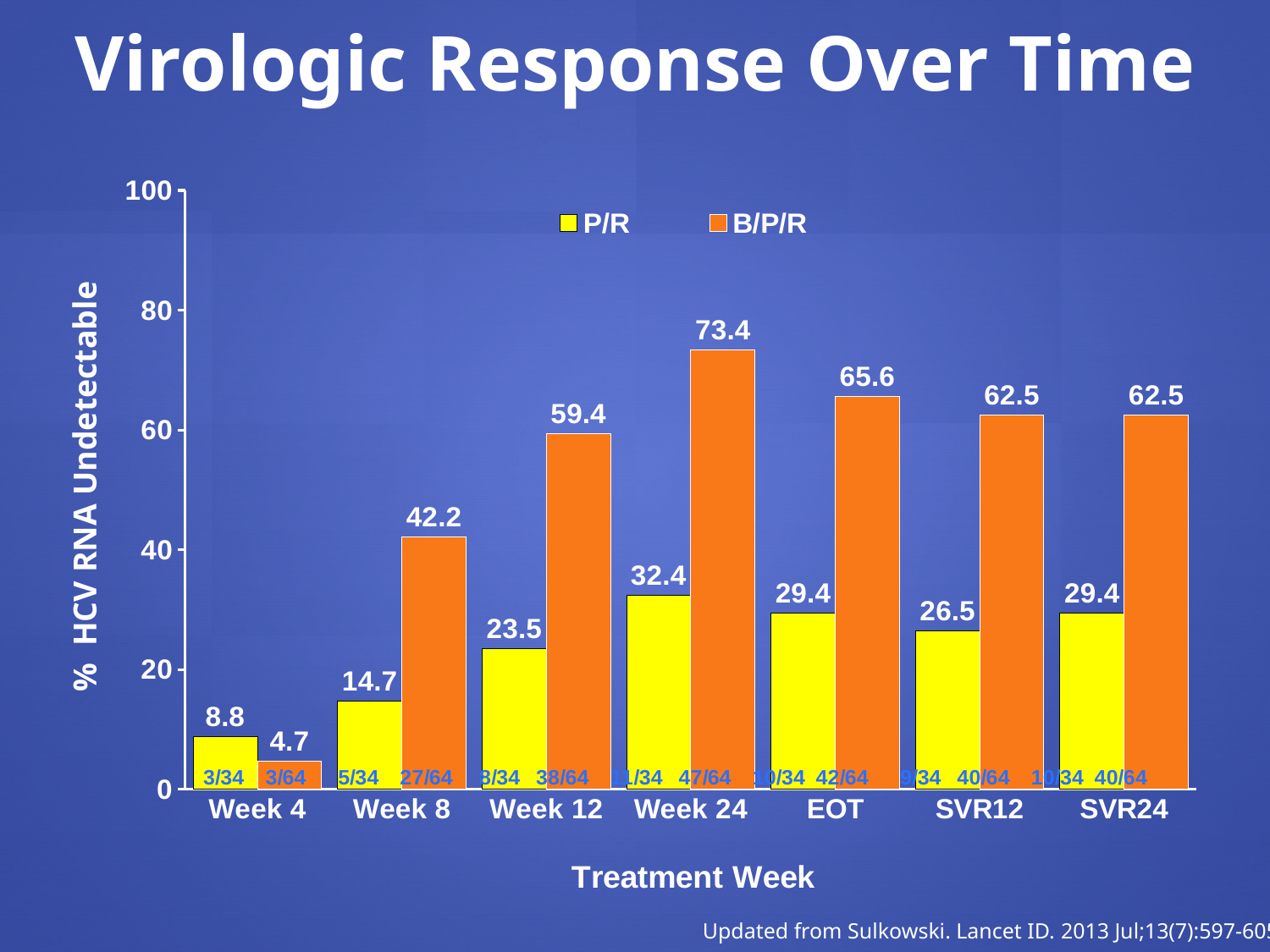
What type of chart is shown on the slide? bar chart What is the value for P/R at Week 8? 14.7 At which category is the P/R value lowest? Week 4 What is the difference between the B/P/R and P/R values at EOT? 36.2 At Week 4, which series has the larger value, P/R or B/P/R? P/R At which category is the B/P/R value highest? Week 24 What is the value for B/P/R at SVR12? 62.5 What is the title of the chart? Virologic Response Over Time Does the B/P/R value rise or fall from Week 4 to Week 24? rise How many series does the legend list? 2 How many categories are shown on the x axis? 7 What is the value for B/P/R at Week 24? 73.4